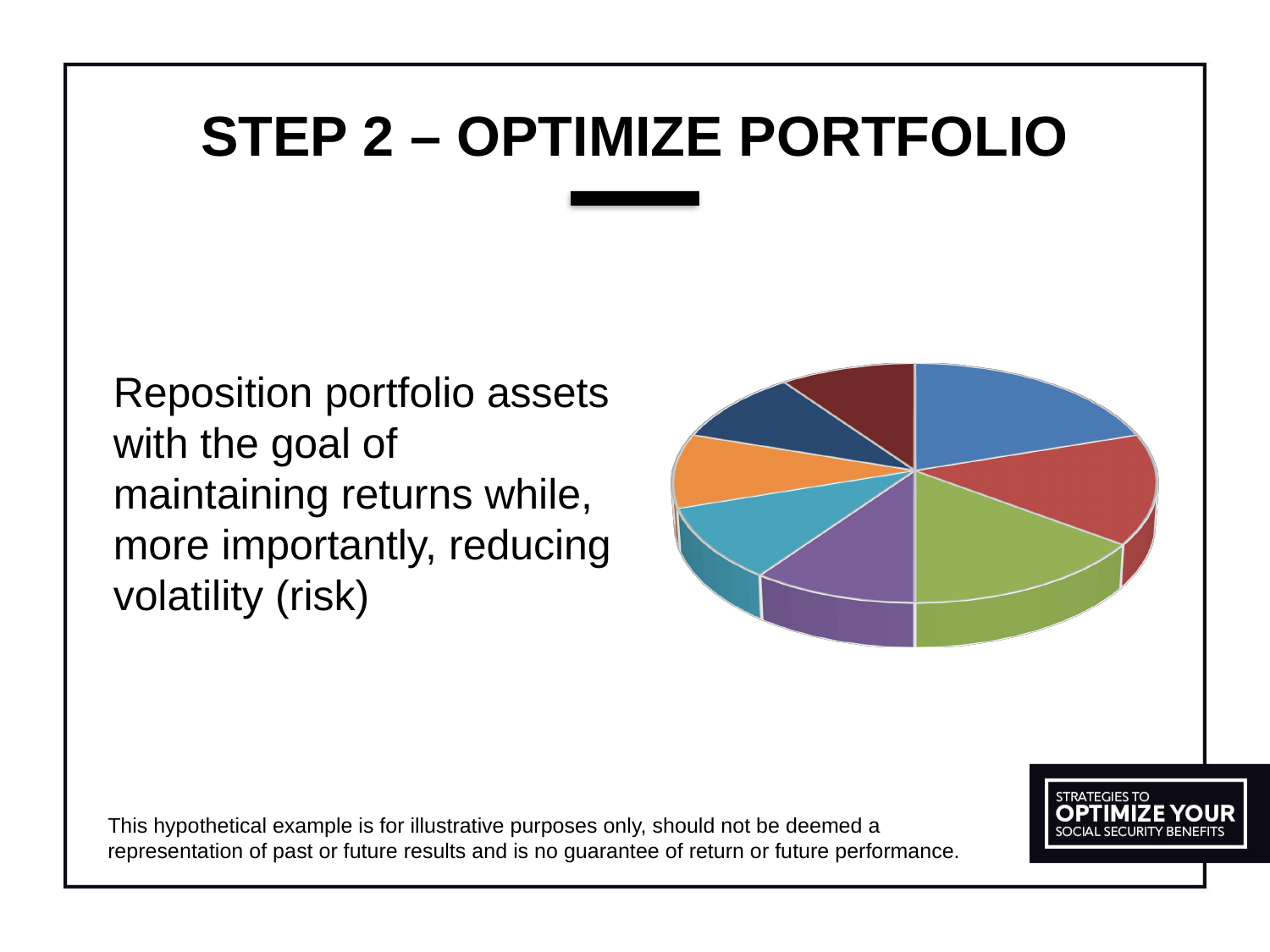
Does the pie chart show data labels with values on its slices? No How many slices does the pie chart have? 8 Does the pie chart display a legend? No What kind of chart is shown on the slide? pie chart Which colour slice is the largest in the pie chart? blue